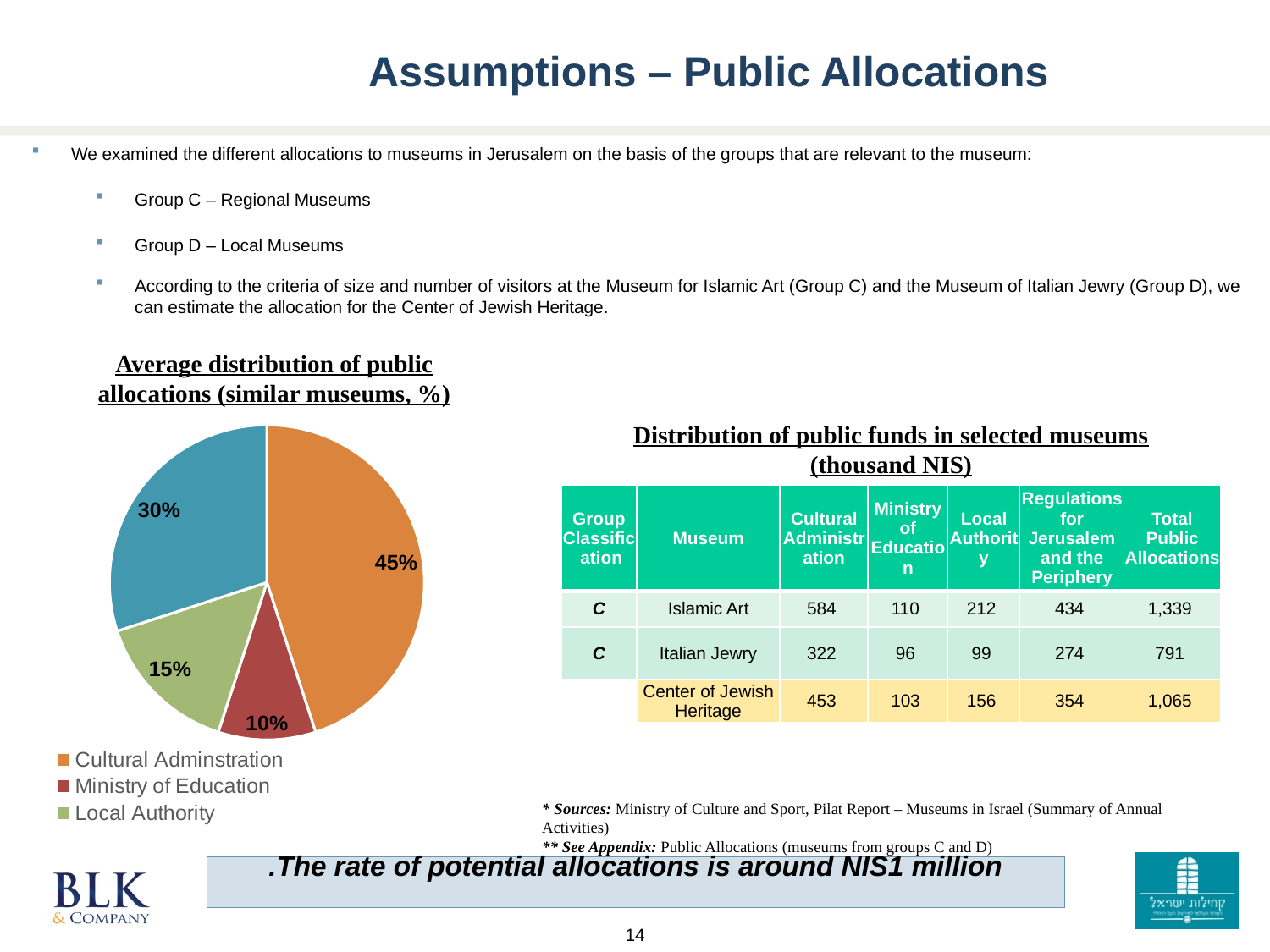
Which is larger in the pie chart, the Local Authority slice or the Ministry of Education slice? Local Authority What is the title of the pie chart? Average distribution of public allocations (similar museums, %) What share of the pie chart does Ministry of Education represent? 10% Which legend category has the largest slice in the pie chart? Cultural Adminstration What share of the pie chart does Cultural Adminstration represent? 45% What share of the pie chart does Local Authority represent? 15% What type of chart is shown on the slide? pie chart What is the difference in percentage points between the Cultural Adminstration slice and the Local Authority slice? 30 How many entries does the pie chart's legend list? 3 How many slices does the pie chart have? 4 What percentage is shown on the blue slice of the pie chart? 30% Which legend category has the smallest slice in the pie chart? Ministry of Education